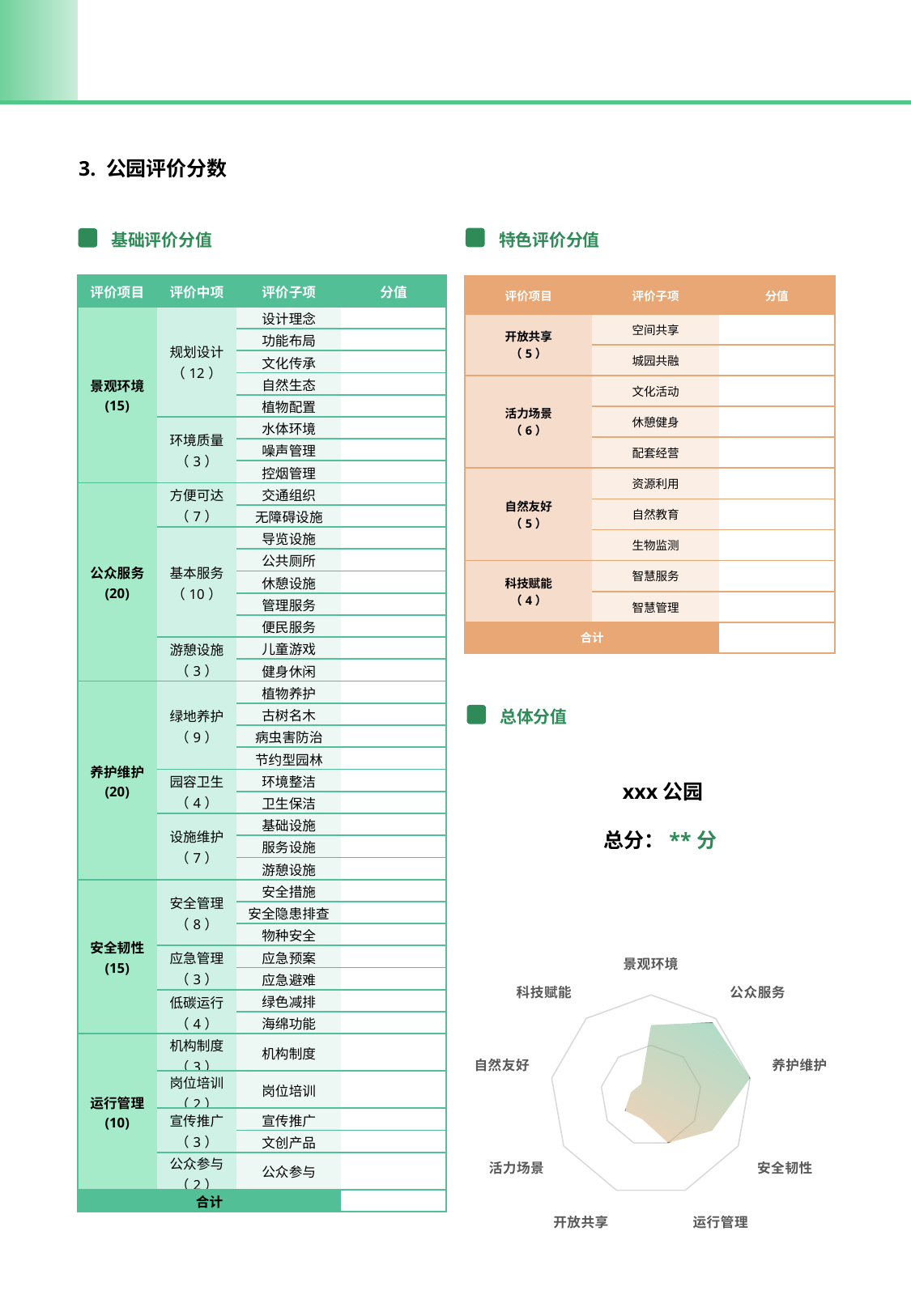
In the radar chart, which is larger, the value for 养护维护 or the value for 自然友好? 养护维护 In the radar chart, which is larger, the value for 景观环境 or the value for 活力场景? 景观环境 How many categories (axes) does the radar chart have? 9 In the radar chart, which is larger, the value for 公众服务 or the value for 开放共享? 公众服务 Which category label appears at the top of the radar chart? 景观环境 Which section heading is the radar chart placed under? 总体分值 What kind of chart is shown under the 总体分值 heading? radar chart